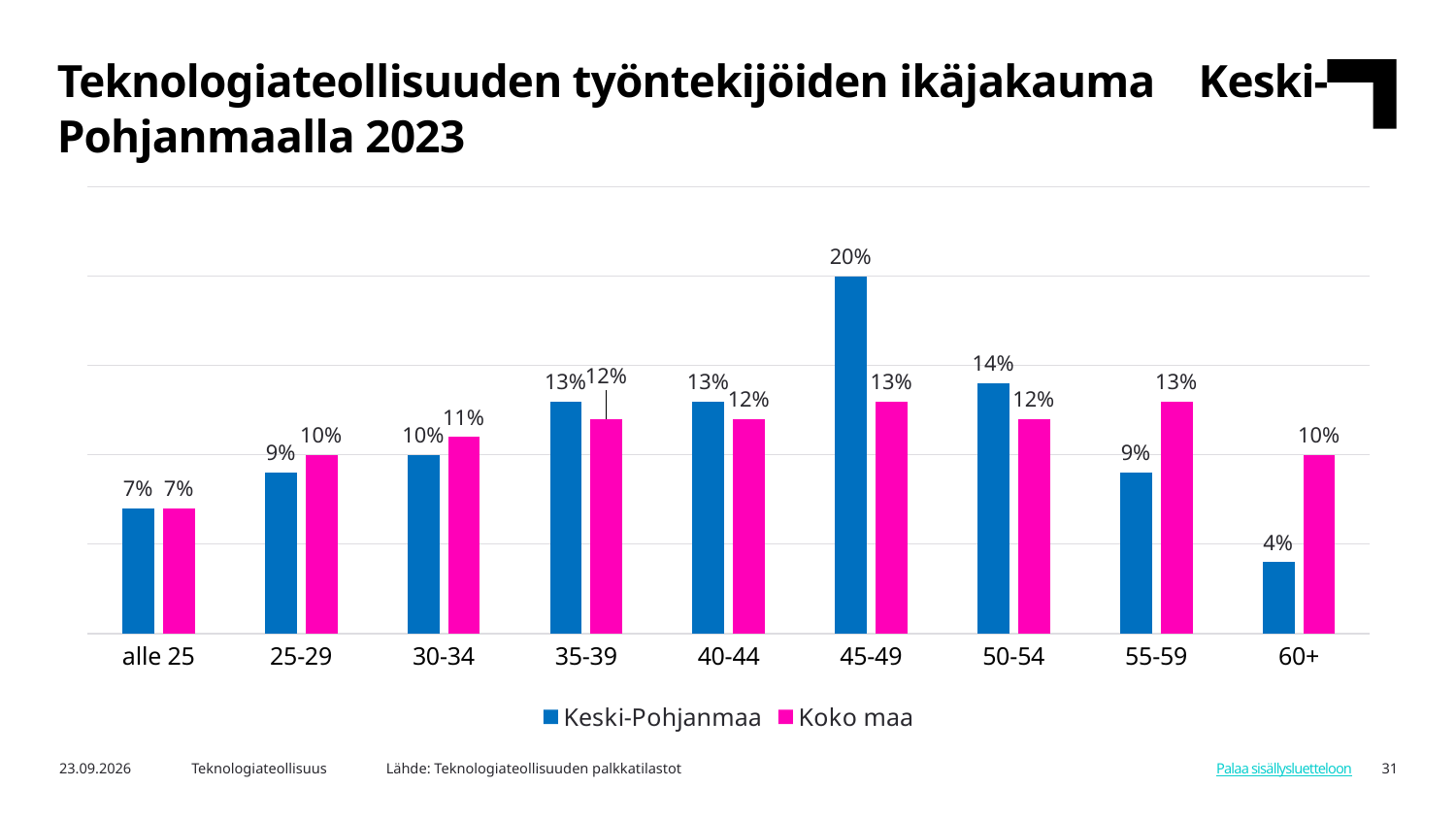
In the 55-59 age group, which series has the larger value, Keski-Pohjanmaa or Koko maa? Koko maa How many age groups are shown on the x axis? 9 What is the value for Keski-Pohjanmaa in the 55-59 age group? 9% Which age group has the lowest value for Keski-Pohjanmaa? 60+ What is the difference between Keski-Pohjanmaa and Koko maa in the 45-49 age group? 7 percentage points Which age group has the lowest value for Koko maa? alle 25 What kind of chart is shown on the slide? Bar chart Which age group has the highest value for Keski-Pohjanmaa? 45-49 How many series does the legend list? 2 What is the difference between Koko maa and Keski-Pohjanmaa in the 60+ age group? 6 percentage points What is the value for Keski-Pohjanmaa in the 45-49 age group? 20% What is the value for Koko maa in the 60+ age group? 10%